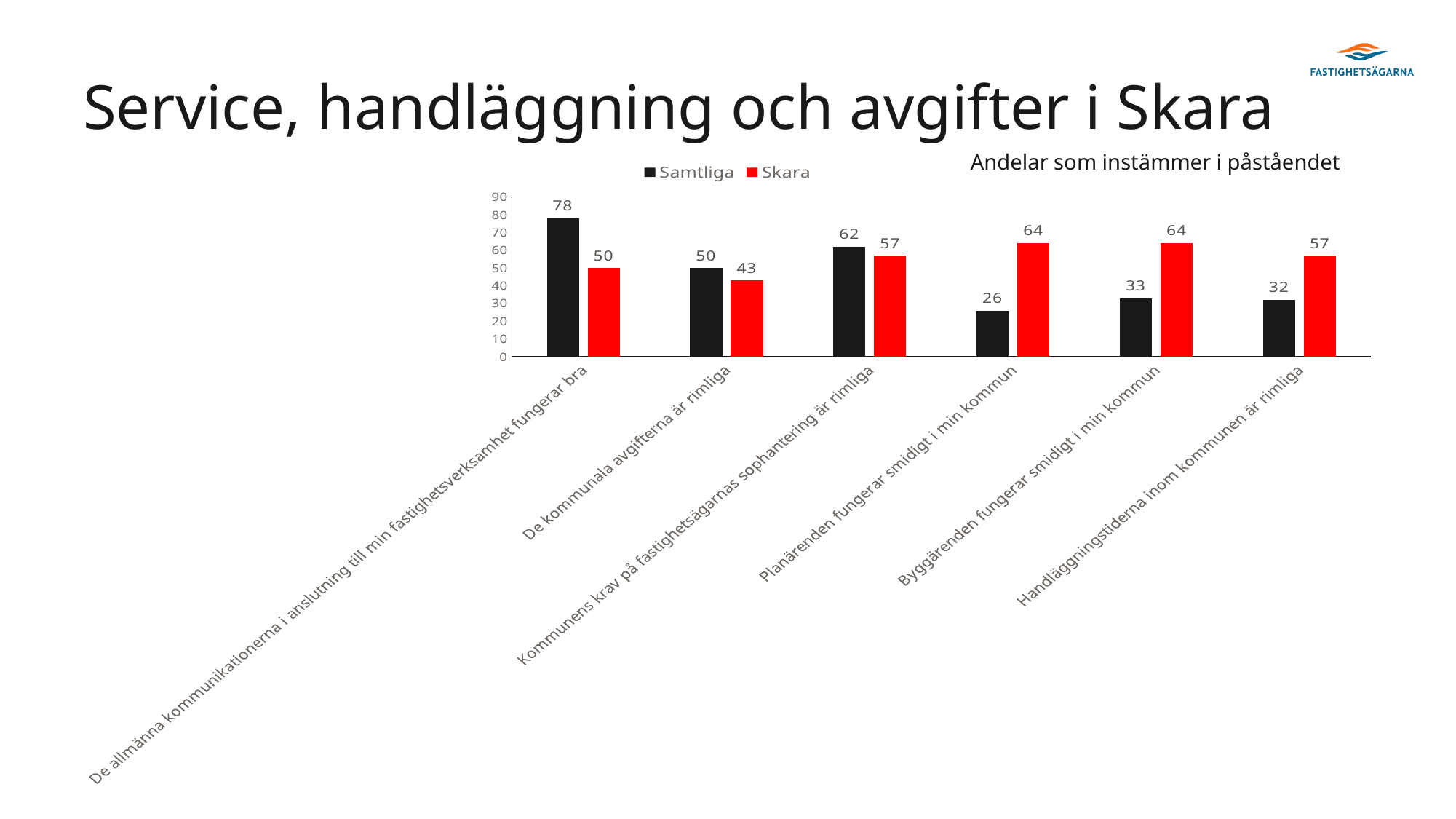
How many categories are shown on the x axis? 6 Which category has the lowest Samtliga value? Planärenden fungerar smidigt i min kommun What is the Samtliga value for "De kommunala avgifterna är rimliga"? 50 Which category has the lowest Skara value? De kommunala avgifterna är rimliga What is the difference between the Skara and Samtliga values for "Planärenden fungerar smidigt i min kommun"? 38 For "Byggärenden fungerar smidigt i min kommun", which series has the larger value, Samtliga or Skara? Skara Which category has the highest Samtliga value? De allmänna kommunikationerna i anslutning till min fastighetsverksamhet fungerar bra How many series does the legend list? 2 What is the Skara value for "Handläggningstiderna inom kommunen är rimliga"? 57 What kind of chart is shown on the slide? Bar chart What is the Skara value for "Planärenden fungerar smidigt i min kommun"? 64 What is the difference between the Samtliga and Skara values for "De allmänna kommunikationerna i anslutning till min fastighetsverksamhet fungerar bra"? 28